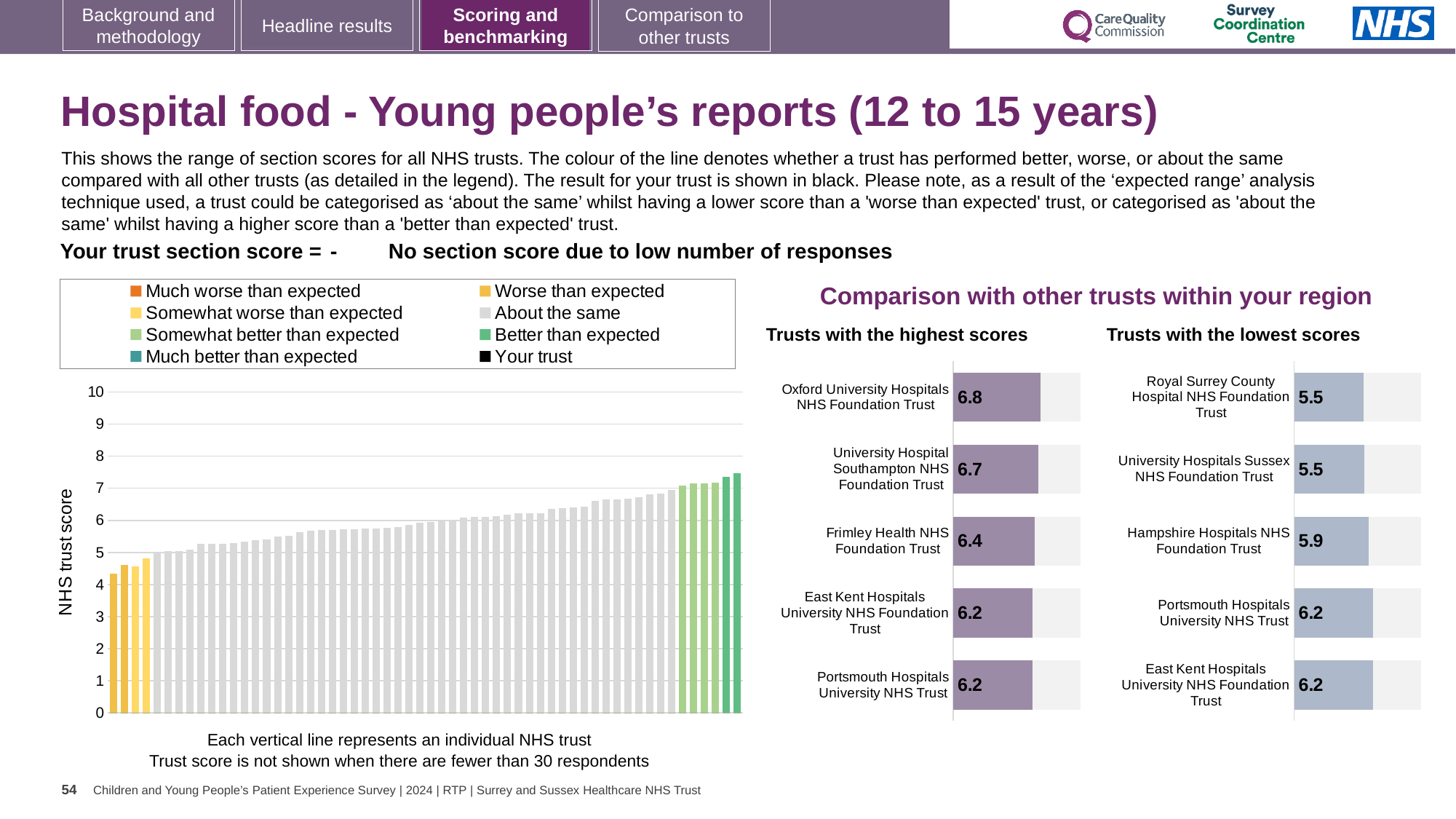
In the large chart on the left showing NHS trust scores, do the values rise or fall from left to right? Rise In the 'Trusts with the lowest scores' chart, what is the score for Royal Surrey County Hospital NHS Foundation Trust? 5.5 How many entries does the legend above the large chart on the left list? 8 In the large chart on the left showing NHS trust scores, is the value of the leftmost bar greater or less than 5? less In the 'Trusts with the highest scores' chart, what is the difference between the scores of Oxford University Hospitals NHS Foundation Trust and Frimley Health NHS Foundation Trust? 0.4 In the 'Trusts with the lowest scores' chart, what is the difference between the scores of Hampshire Hospitals NHS Foundation Trust and Royal Surrey County Hospital NHS Foundation Trust? 0.4 In the 'Trusts with the lowest scores' chart, what is the score for Hampshire Hospitals NHS Foundation Trust? 5.9 In the 'Trusts with the highest scores' chart, what is the score for Oxford University Hospitals NHS Foundation Trust? 6.8 In the 'Trusts with the highest scores' chart, what is the score for Frimley Health NHS Foundation Trust? 6.4 What kind of chart is the large chart on the left showing NHS trust scores? Bar chart In the 'Trusts with the highest scores' chart, which has the larger score: University Hospital Southampton NHS Foundation Trust or Frimley Health NHS Foundation Trust? University Hospital Southampton NHS Foundation Trust In the 'Trusts with the highest scores' chart, which trust has the highest score? Oxford University Hospitals NHS Foundation Trust